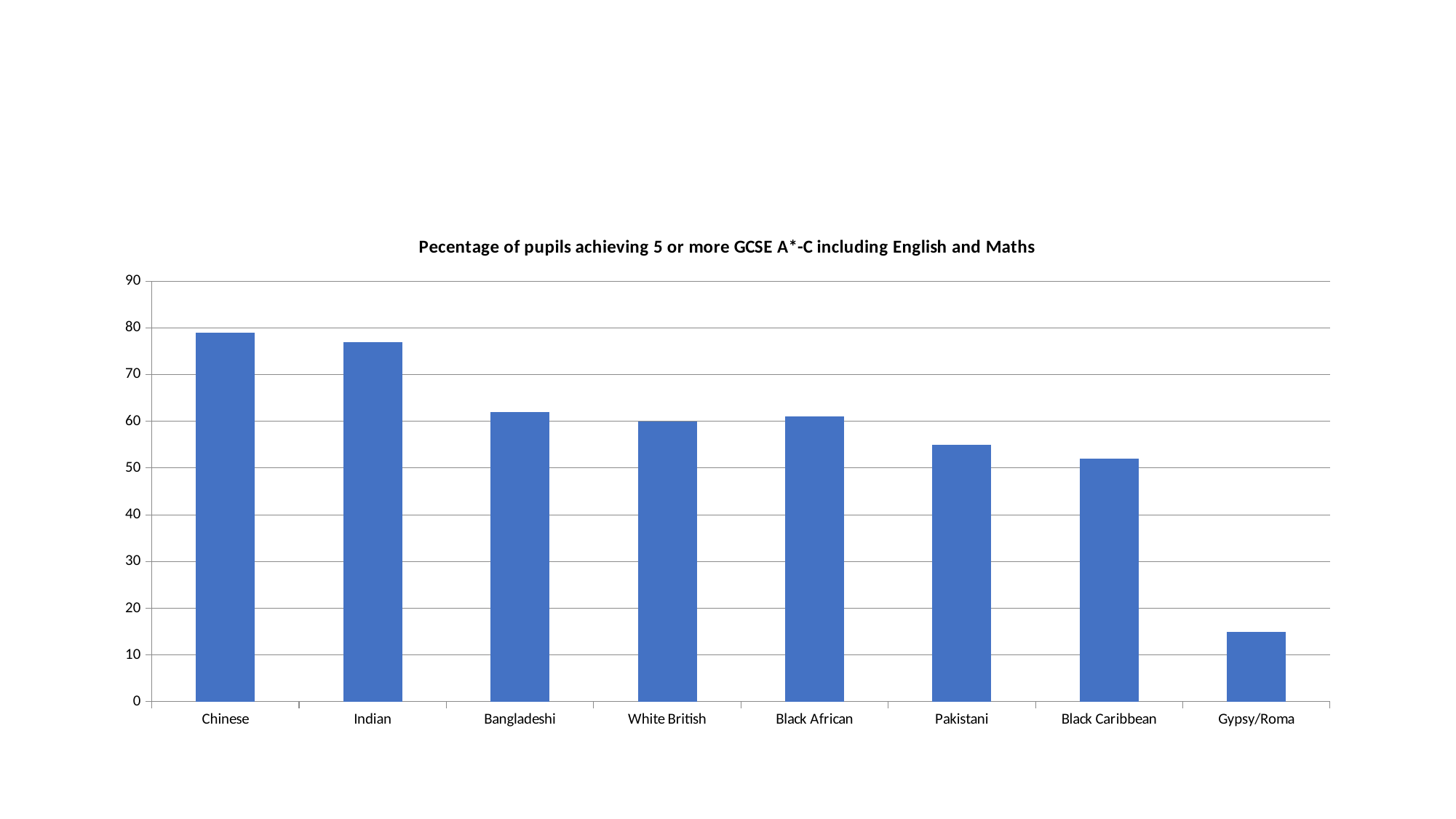
Is the value for Indian greater or less than 80? less Which is larger, the value for Pakistani or the value for Black Caribbean? Pakistani Which group has the highest percentage of pupils achieving 5 or more GCSE A*-C including English and Maths? Chinese Is the value for Black Caribbean greater or less than 60? less What kind of chart is shown on the slide? bar chart Is the value for Gypsy/Roma greater or less than 20? less How many ethnic groups are shown on the x axis of the chart? 8 Do the values generally rise or fall moving from left to right along the x axis? fall What is the title of the chart? Pecentage of pupils achieving 5 or more GCSE A*-C including English and Maths Which group has the lowest percentage of pupils achieving 5 or more GCSE A*-C including English and Maths? Gypsy/Roma